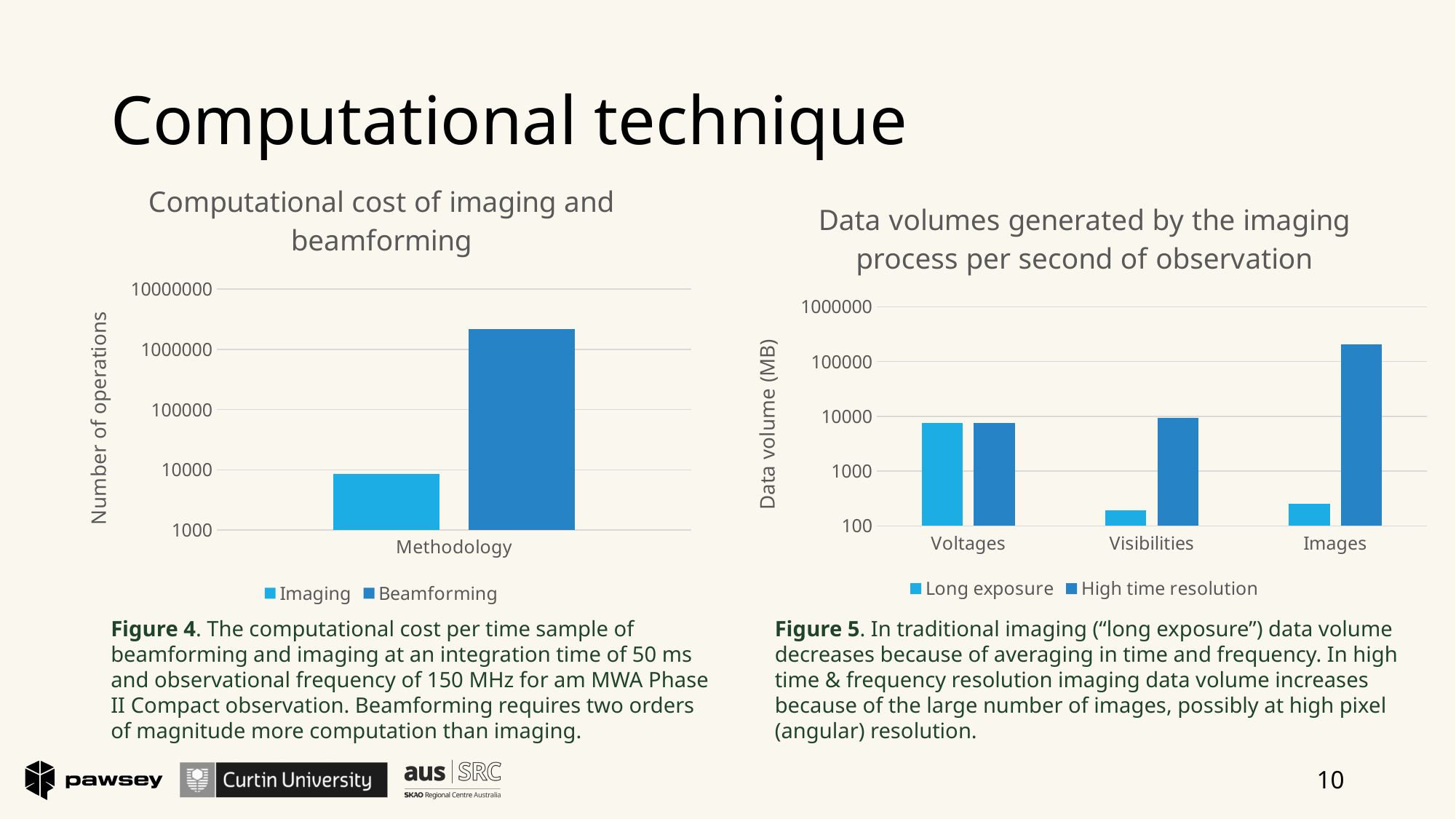
On the left chart, 'Computational cost of imaging and beamforming', what is the y-axis title? Number of operations On the right chart, 'Data volumes generated by the imaging process per second of observation', how many series does the legend list? 2 On the right chart, 'Data volumes generated by the imaging process per second of observation', is the Long exposure value for Visibilities greater or less than 1000? less On the right chart, 'Data volumes generated by the imaging process per second of observation', how many categories are shown on the x axis? 3 On the left chart, 'Computational cost of imaging and beamforming', what kind of chart is shown? bar chart On the left chart, 'Computational cost of imaging and beamforming', which series has the larger value, Imaging or Beamforming? Beamforming On the right chart, 'Data volumes generated by the imaging process per second of observation', for Visibilities, which series has the larger value, Long exposure or High time resolution? High time resolution On the left chart, 'Computational cost of imaging and beamforming', is the value for Beamforming greater or less than 1000000? greater On the right chart, 'Data volumes generated by the imaging process per second of observation', which bar is the highest? High time resolution for Images On the left chart, 'Computational cost of imaging and beamforming', how many series does the legend list? 2 On the right chart, 'Data volumes generated by the imaging process per second of observation', is the High time resolution value for Images greater or less than 100000? greater